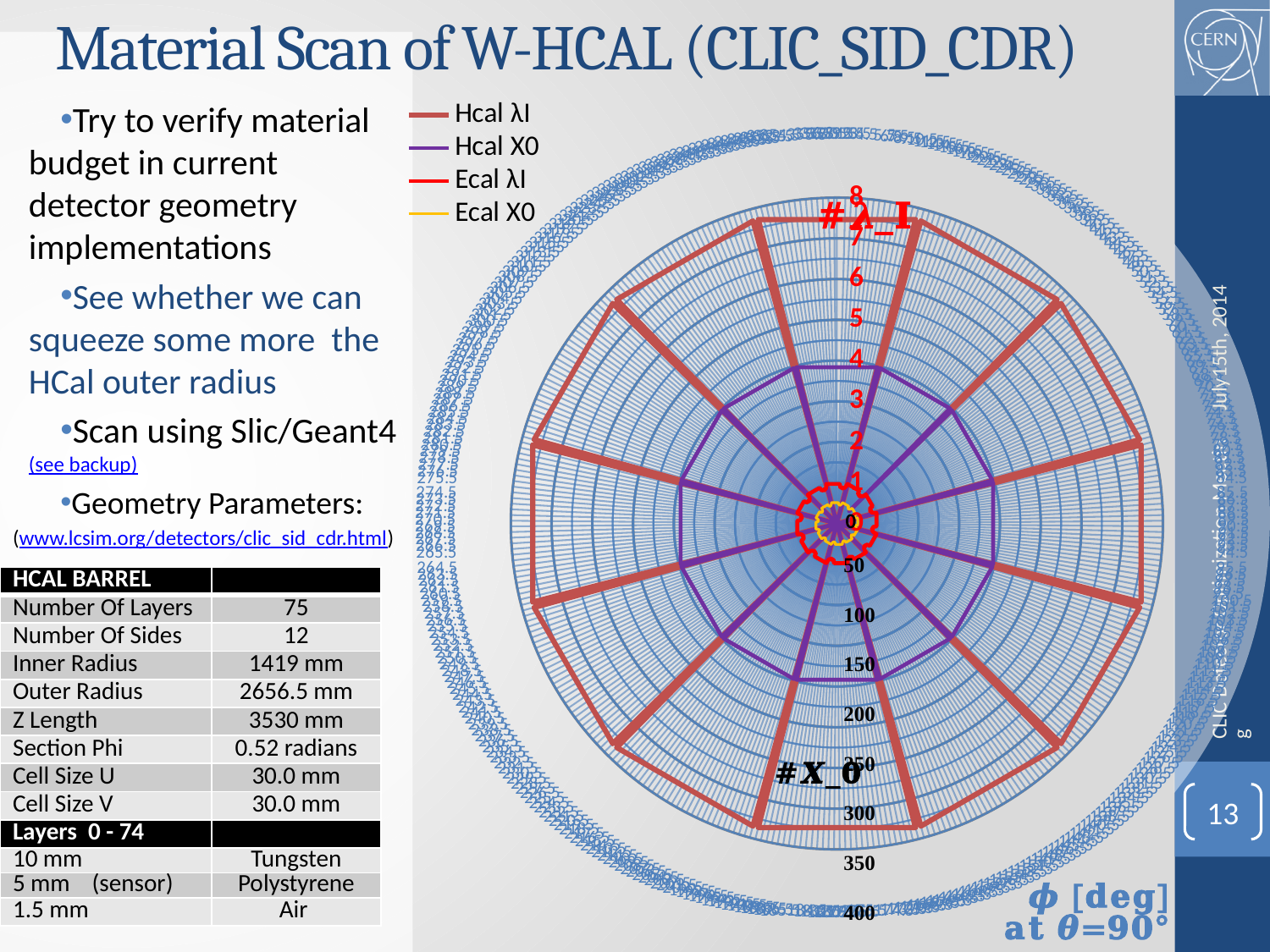
Which is larger on the chart, the Hcal X0 polygon or the Ecal X0 polygon? Hcal X0 What kind of chart is shown on the slide? Radar chart What is the highest tick label shown on the X0 radial scale of the chart? 400 Is the Hcal λI value at the top of the chart greater or less than 4 on the λI scale? greater Which series are listed in the chart legend? Hcal λI, Hcal X0, Ecal λI, Ecal X0 Which series forms the outermost polygon on the chart? Hcal λI What colour is the Hcal X0 series drawn in? Purple How many series does the chart legend list? 4 Which series forms the smallest polygon closest to the centre of the chart? Ecal X0 How many vertices (sides) does the Hcal λI polygon on the chart have? 12 Which is larger on the chart, the Hcal λI polygon or the Ecal λI polygon? Hcal λI